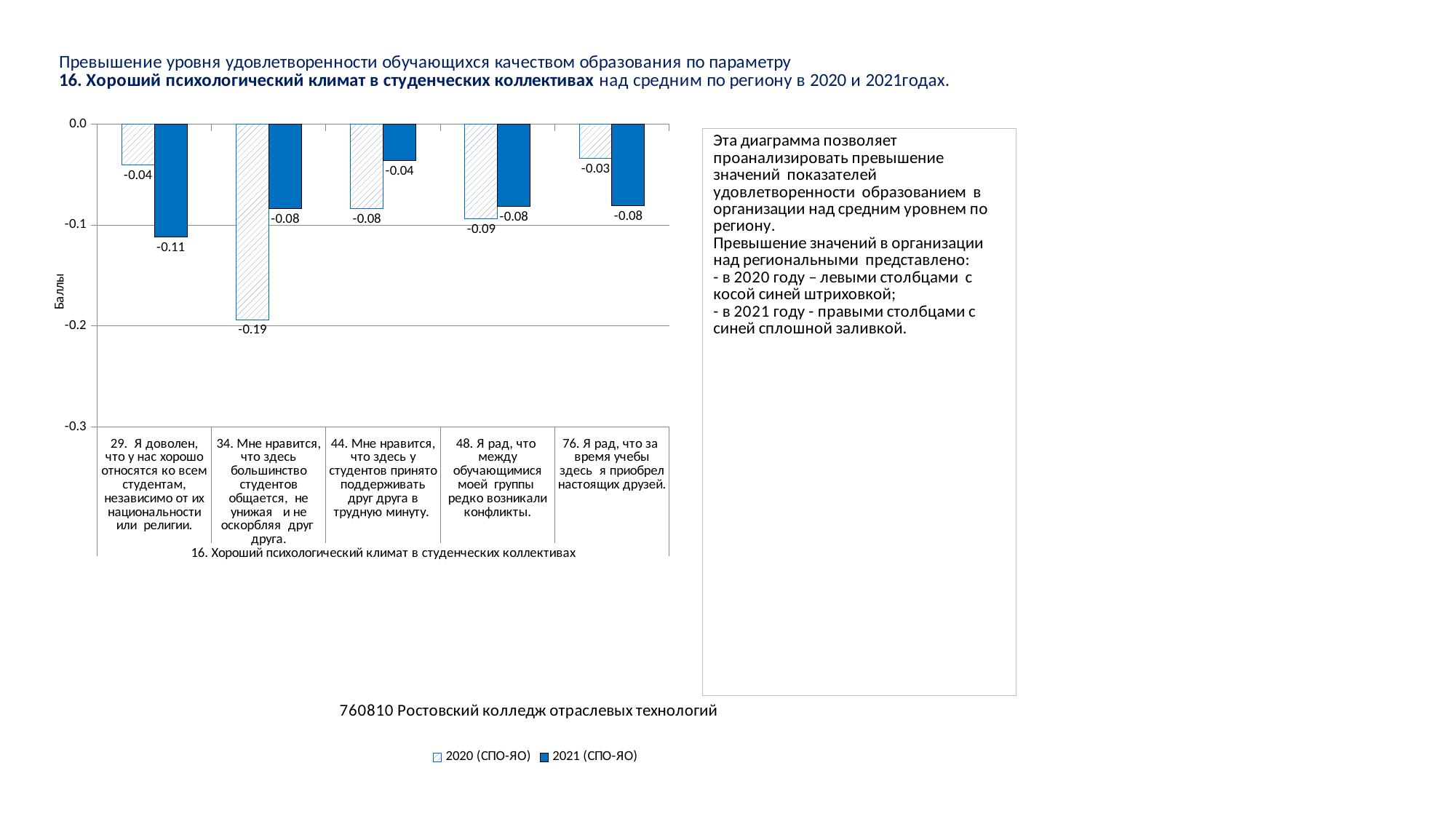
What is the 2020 (СПО-ЯО) value for category 29 (Я доволен, что у нас хорошо относятся ко всем студентам...)? -0.04 Which category has the lowest 2020 (СПО-ЯО) value? 34. Мне нравится, что здесь большинство студентов общается, не унижая и не оскорбляя друг друга. What is the label of the vertical axis? Баллы What is the difference between the 2020 and 2021 values for category 34? 0.11 How many series does the legend list? 2 What is the 2021 (СПО-ЯО) value for category 34 (Мне нравится, что здесь большинство студентов общается, не унижая и не оскорбляя друг друга)? -0.08 How many categories (questions) are shown on the x axis? 5 What is the 2021 (СПО-ЯО) value for category 44 (Мне нравится, что здесь у студентов принято поддерживать друг друга в трудную минуту)? -0.04 Which category has the lowest 2021 (СПО-ЯО) value? 29. Я доволен, что у нас хорошо относятся ко всем студентам, независимо от их национальности или религии. For category 48 (Я рад, что между обучающимися моей группы редко возникали конфликты), which is larger: the 2020 value or the 2021 value? 2021 (-0.08) What type of chart is shown? Bar chart What is the 2020 (СПО-ЯО) value for category 76 (Я рад, что за время учебы здесь я приобрел настоящих друзей)? -0.03